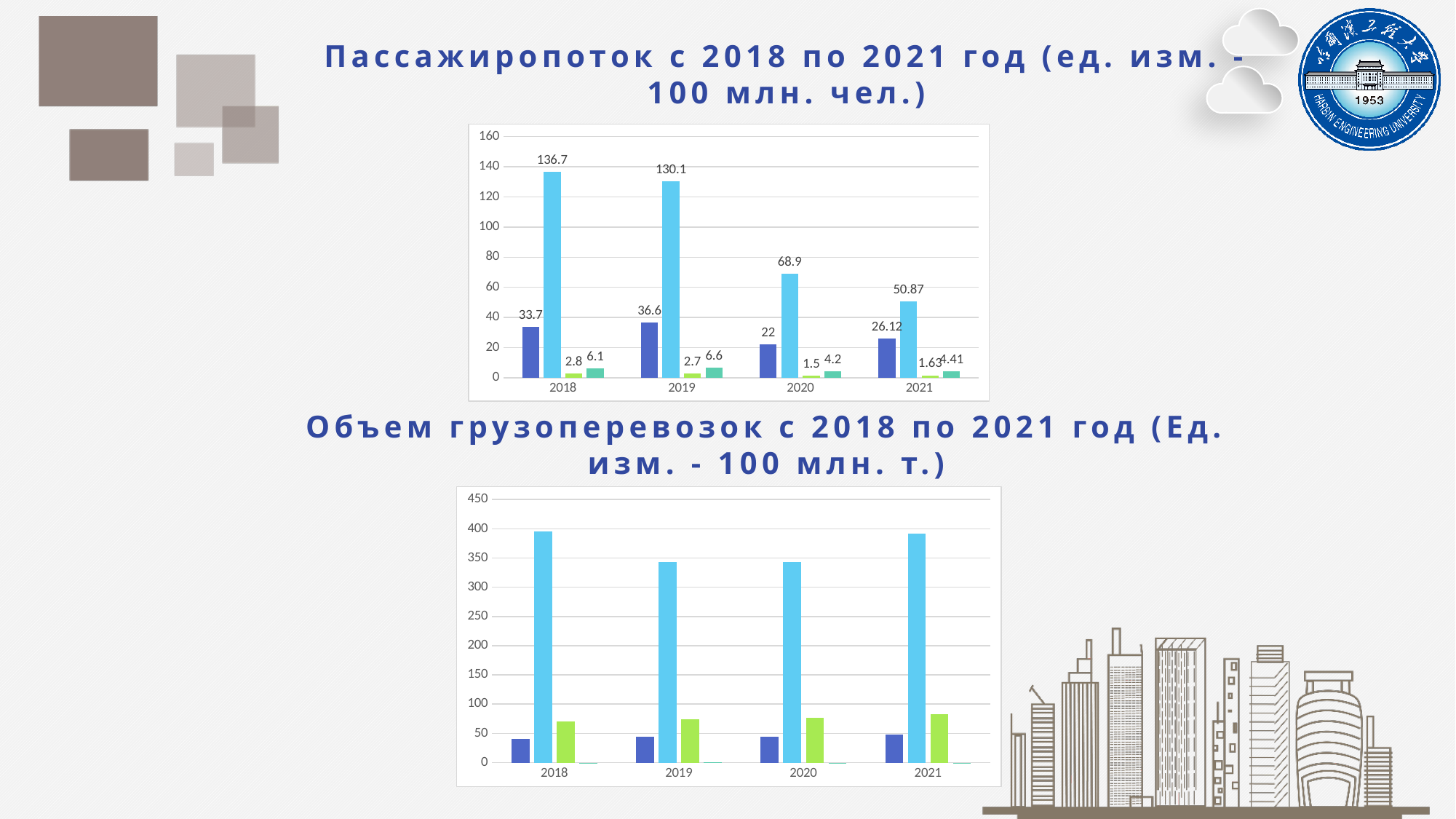
What kind of chart is the bottom chart (Объем грузоперевозок)? bar chart In the bottom chart (Объем грузоперевозок), how many years are shown on the x axis? 4 In the top chart (Пассажиропоток), is the dark blue bar larger in 2018 or in 2019? 2019 In the top chart (Пассажиропоток), what is the value of the dark blue bar for 2020? 22 In the top chart (Пассажиропоток), what is the value of the green bar for 2021? 1.63 In the top chart (Пассажиропоток), what is the difference between the light blue bar values for 2018 and 2019? 6.6 In the bottom chart (Объем грузоперевозок), is the value of the light blue bar for 2018 greater or less than 350? greater In the top chart (Пассажиропоток), do the light blue bars rise or fall from 2018 to 2021? fall In the top chart (Пассажиропоток), what is the value of the teal bar for 2019? 6.6 In the top chart (Пассажиропоток), what is the value of the light blue bar for 2018? 136.7 In the top chart (Пассажиропоток), in which year is the light blue bar highest? 2018 In the top chart (Пассажиропоток), in which year is the dark blue bar lowest? 2020